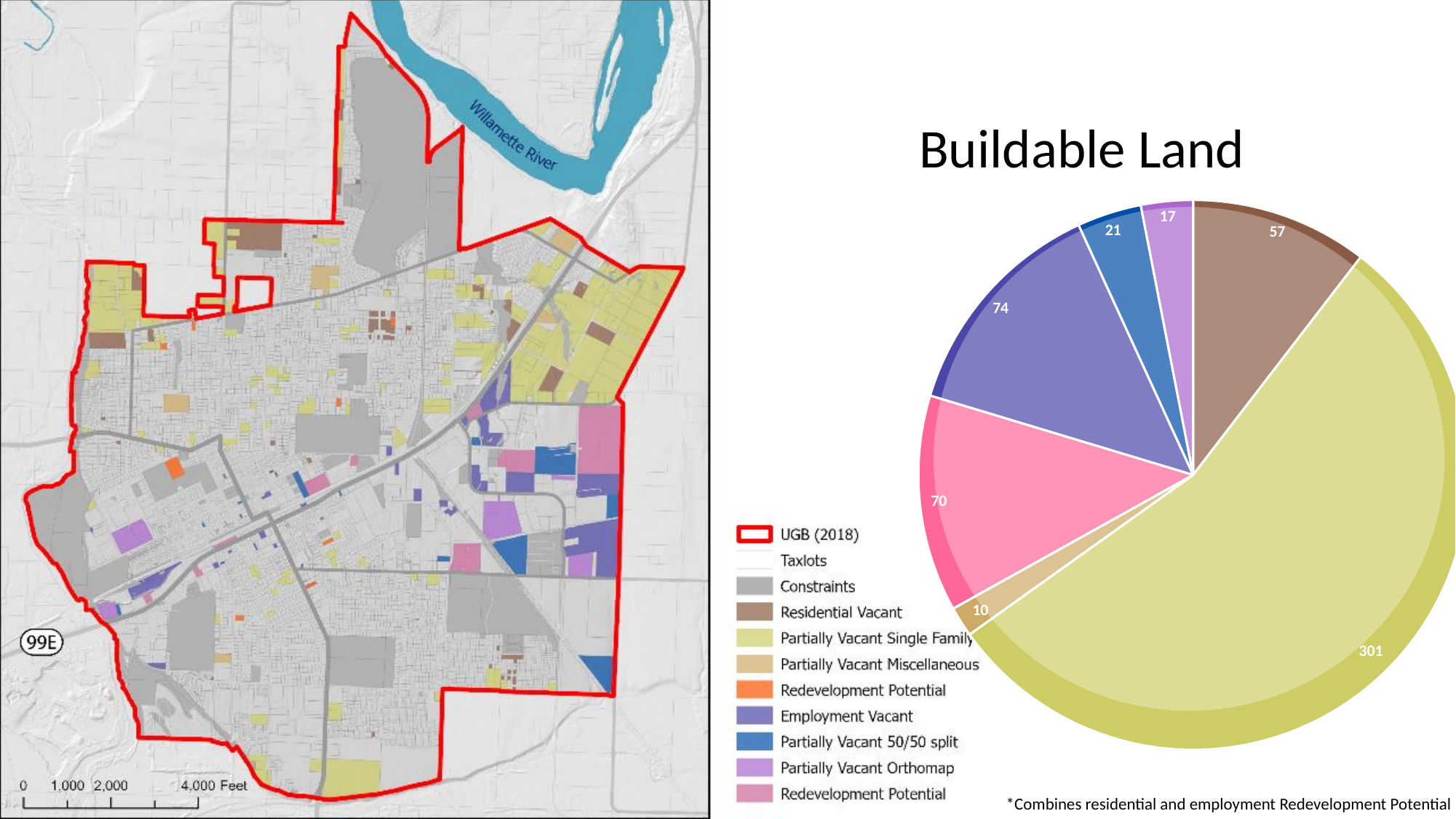
In the Buildable Land pie chart, what value is shown on the dark blue slice? 21 What is the title of the chart on the right side of the slide? Buildable Land In the Buildable Land pie chart, what value is shown on the brown slice? 57 How many slices does the Buildable Land pie chart have? 7 In the Buildable Land pie chart, what is the difference between the largest slice (301) and the brown slice (57)? 244 In the Buildable Land pie chart, what value is shown on the pink slice? 70 What is the value of the smallest slice in the Buildable Land pie chart? 10 In the Buildable Land pie chart, which is larger: the purple-blue slice labelled 74 or the pink slice labelled 70? the purple-blue slice (74) What kind of chart is shown under the title "Buildable Land"? pie chart What is the value of the largest slice in the Buildable Land pie chart? 301 What does the footnote under the Buildable Land pie chart say? *Combines residential and employment Redevelopment Potential What is the total of all slice values in the Buildable Land pie chart? 550